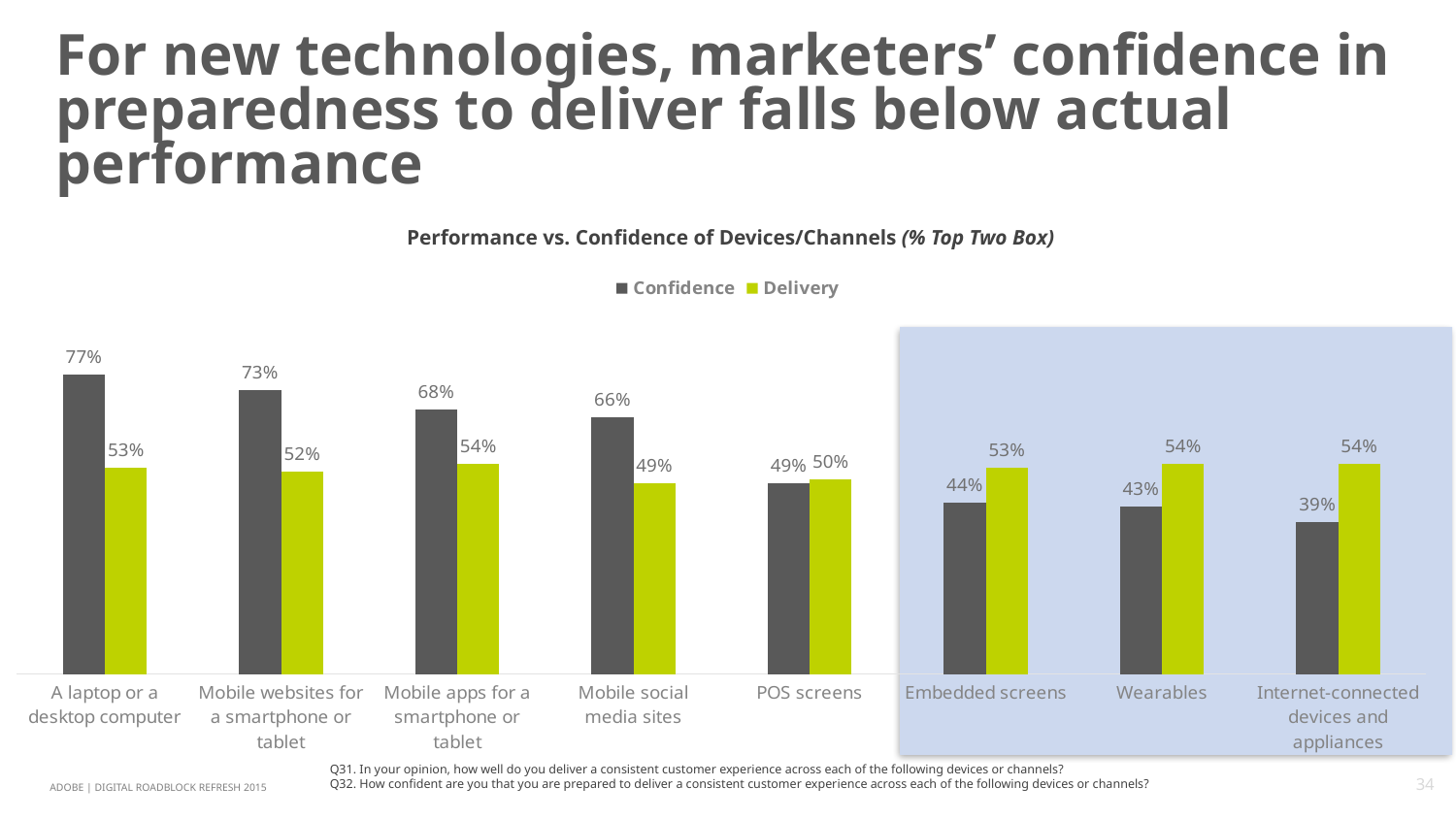
What is the difference between the Confidence and Delivery values for Mobile websites for a smartphone or tablet? 21 percentage points What is the Delivery value for Mobile social media sites? 49% For Embedded screens, which is larger: Confidence or Delivery? Delivery Which category has the lowest Confidence value? Internet-connected devices and appliances What is the Delivery value for Wearables? 54% Do the Confidence values rise or fall moving from left to right along the x axis? Fall What kind of chart is shown on the slide? Bar chart What is the Confidence value for Internet-connected devices and appliances? 39% How many series does the legend list? 2 Which category has the highest Confidence value? A laptop or a desktop computer How many categories are shown on the x axis? 8 What is the Confidence value for A laptop or a desktop computer? 77%